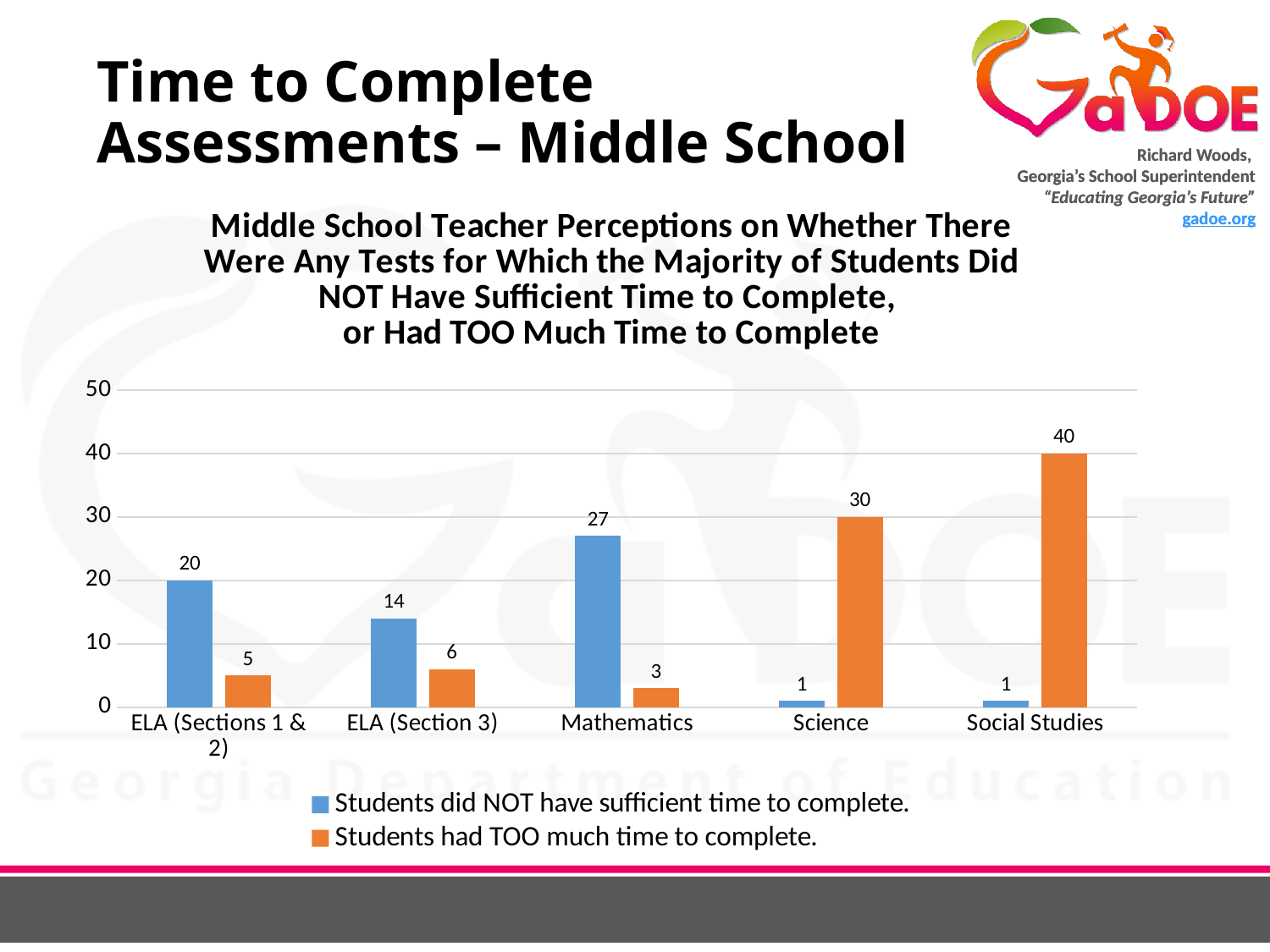
Which category has the lowest value in the 'Students had TOO much time to complete.' series? Mathematics How many series does the legend list? 2 What is the value for ELA (Section 3) in the 'Students had TOO much time to complete.' series? 6 For ELA (Sections 1 & 2), which series has the larger value? Students did NOT have sufficient time to complete. How many categories are shown on the x axis? 5 What is the difference between the two series values for Science? 29 What is the value for Social Studies in the 'Students had TOO much time to complete.' series? 40 Which category has the highest value in the 'Students had TOO much time to complete.' series? Social Studies What is the value for Mathematics in the 'Students did NOT have sufficient time to complete.' series? 27 What colour represents the 'Students had TOO much time to complete.' series? Orange Which category has the highest value in the 'Students did NOT have sufficient time to complete.' series? Mathematics What kind of chart is shown on the slide? Bar chart